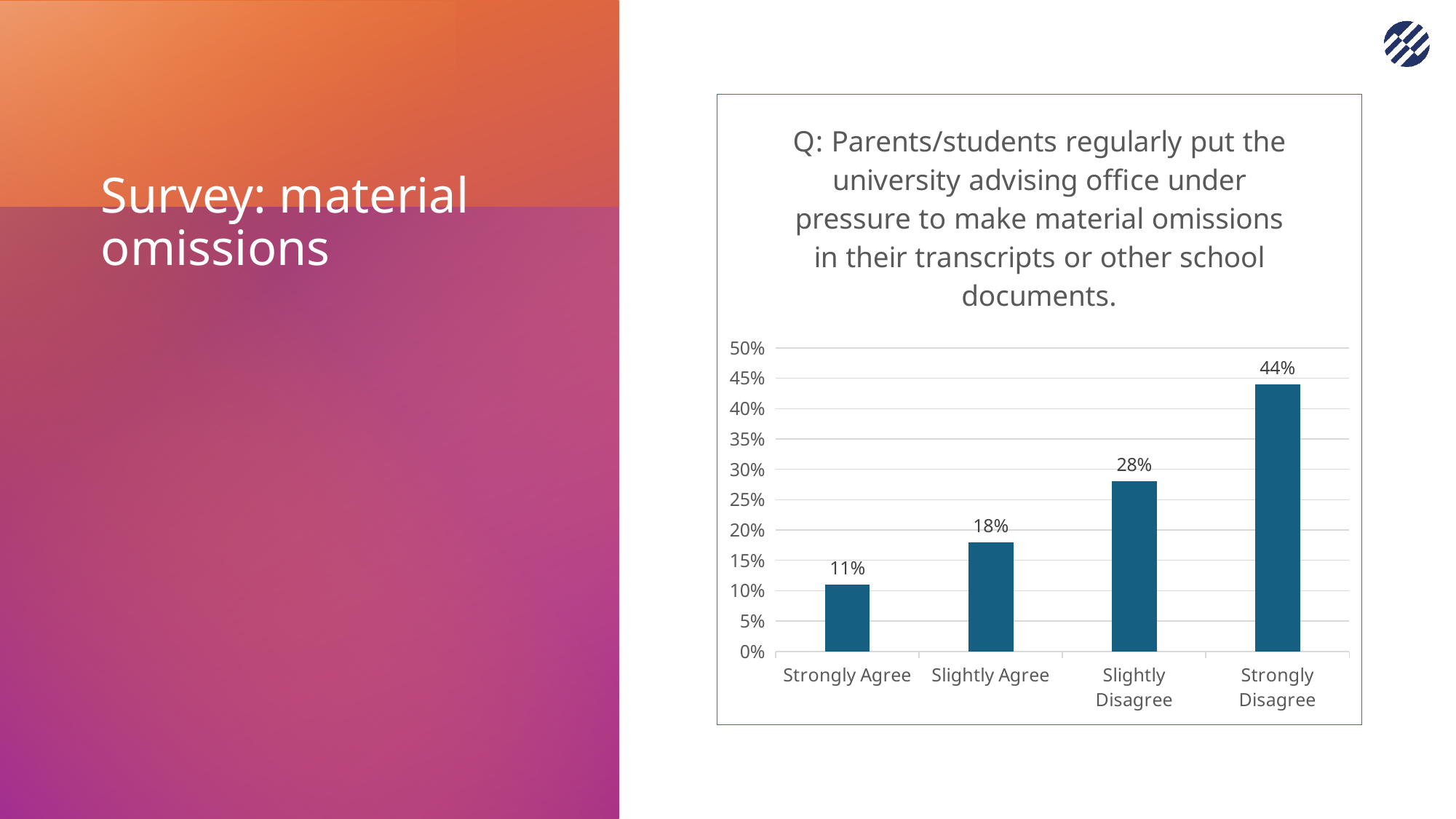
Do the values rise or fall moving from Strongly Agree to Strongly Disagree along the x axis? Rise Which is larger, the value for Slightly Agree or the value for Slightly Disagree? Slightly Disagree How many response categories are shown on the chart? 4 What percentage of respondents answered Strongly Disagree? 44% What is the difference in percentage points between Strongly Disagree and Strongly Agree? 33 percentage points What percentage of respondents answered Strongly Agree? 11% Is the value for Strongly Disagree greater or less than 40%? greater Which response category has the highest percentage? Strongly Disagree What percentage of respondents answered Slightly Disagree? 28% What percentage of respondents answered Slightly Agree? 18% Which response category has the lowest percentage? Strongly Agree What kind of chart is shown on the slide? Bar chart